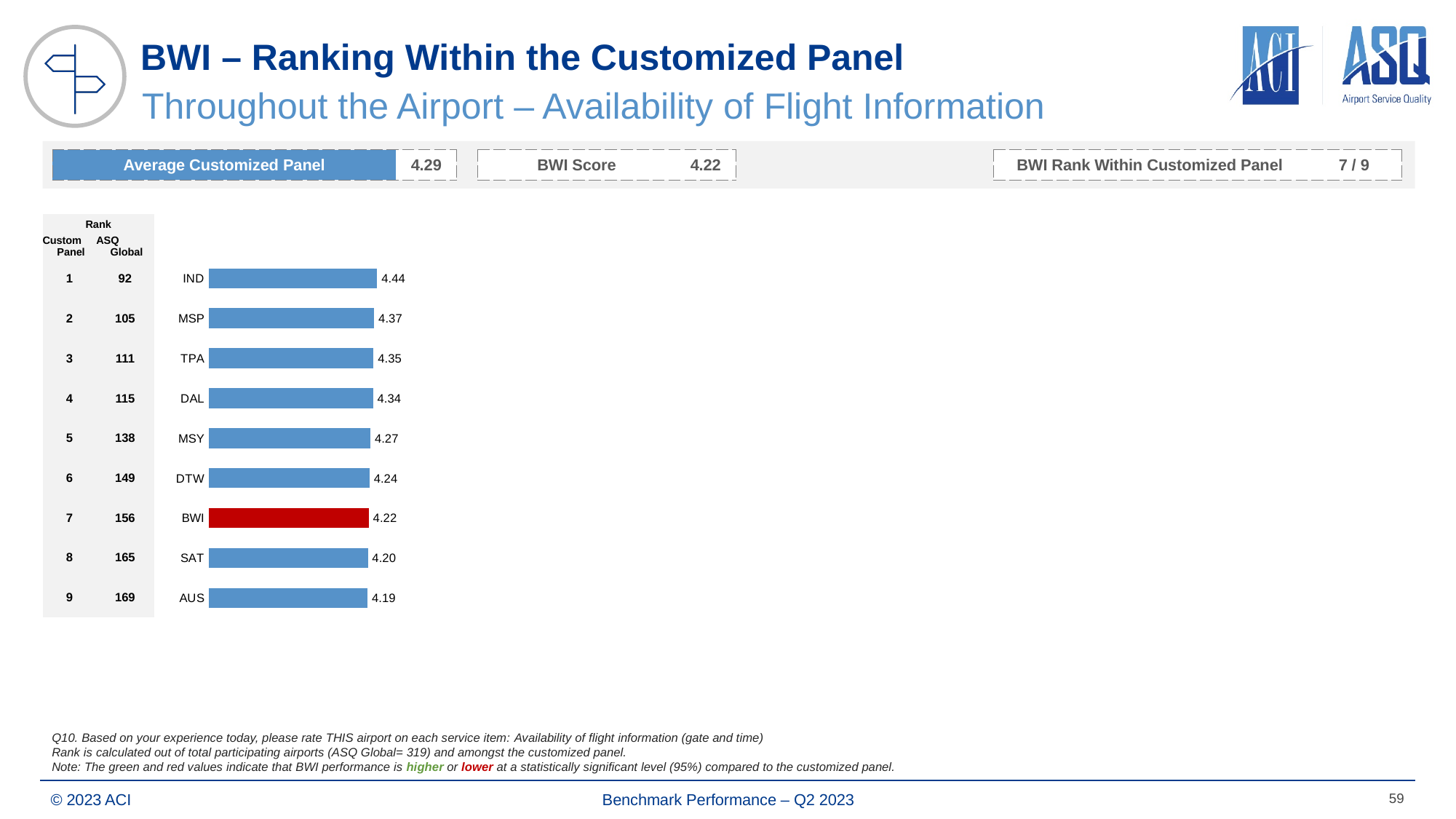
How many airports are shown in the chart? 9 What is the difference between the values for MSP and SAT? 0.17 What is the difference between the values for IND and BWI? 0.22 What is the value for MSY? 4.27 Which airport has the lowest value? AUS What is the value for AUS? 4.19 Which airport's bar is coloured red? BWI What is the value for BWI? 4.22 What kind of chart is shown on the slide? bar chart What is the value for IND? 4.44 Which airport has the highest value? IND Which has a larger value, TPA or DTW? TPA